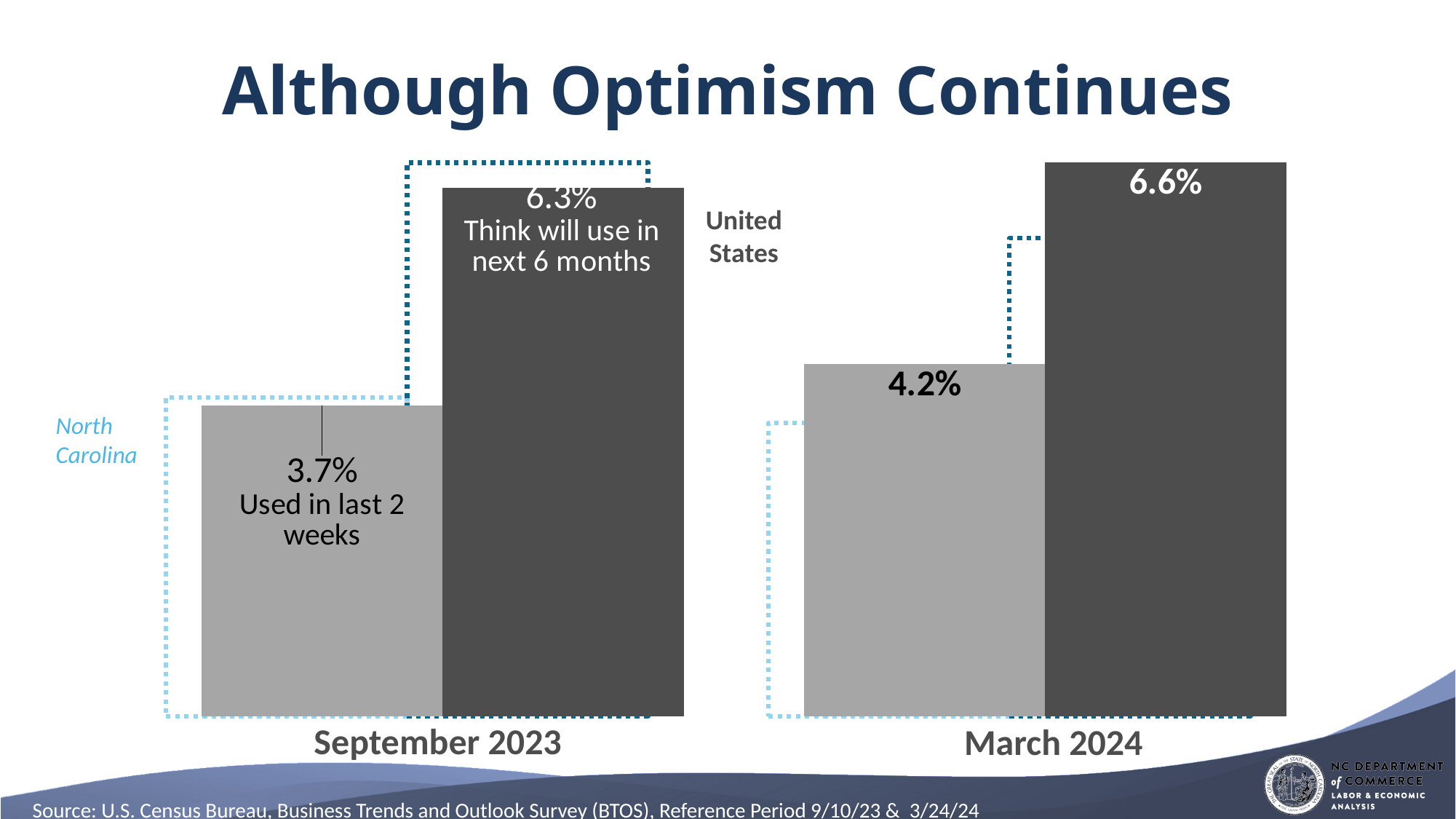
What is the value for "Think will use in next 6 months" in September 2023? 6.3% What is the value for "Used in last 2 weeks" in September 2023? 3.7% What is the difference between the "Think will use in next 6 months" value and the "Used in last 2 weeks" value in March 2024? 2.4 percentage points What is the value for "Used in last 2 weeks" in March 2024? 4.2% What kind of chart is shown on the slide? Bar chart Which labeled bar has the highest value on the chart? Think will use in next 6 months, March 2024 (6.6%) Which labeled bar has the lowest value on the chart? Used in last 2 weeks, September 2023 (3.7%) What is the difference between the "Think will use in next 6 months" value and the "Used in last 2 weeks" value in September 2023? 2.6 percentage points By how much did the "Used in last 2 weeks" value change from September 2023 to March 2024? 0.5 percentage points What is the value for "Think will use in next 6 months" in March 2024? 6.6% Which is larger: the "Think will use in next 6 months" value in September 2023 or in March 2024? March 2024